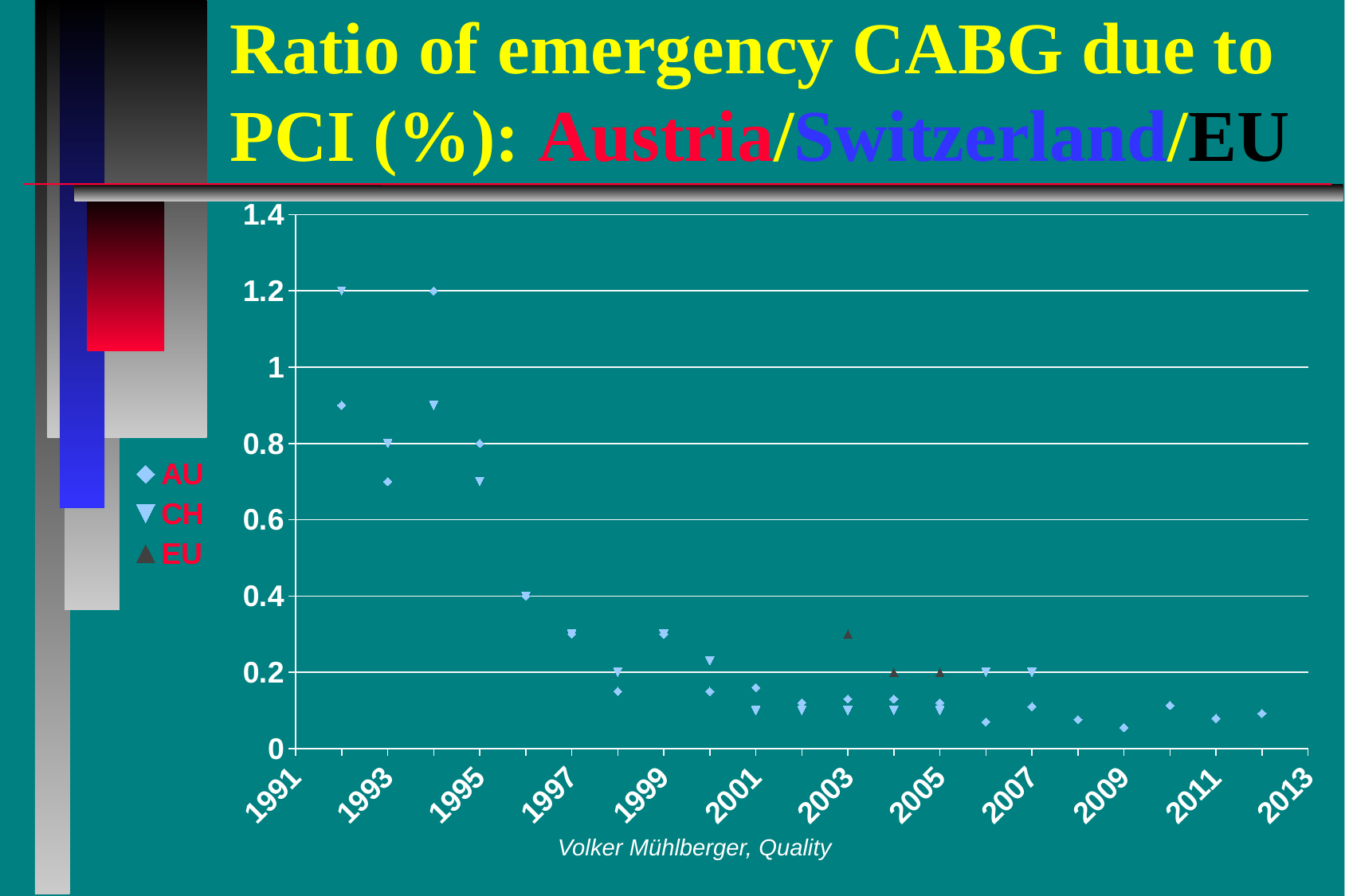
Is the CH value for 1996 greater or less than 0.6? less Is the AU value for 1992 greater or less than 0.8? greater Which is larger, the CH value for 1992 or the CH value for 1993? 1992 Which is larger, the AU value for 1993 or the AU value for 1994? 1994 Is the AU value for 2009 greater or less than 0.2? less What is the CH value for 1992? 1.2 Do the AU values generally rise or fall from 1992 to 2012? fall How many series does the legend list? 3 What are the three series named in the legend? AU, CH, EU What kind of chart is shown on the slide? scatter chart How many EU data points are plotted on the chart? 3